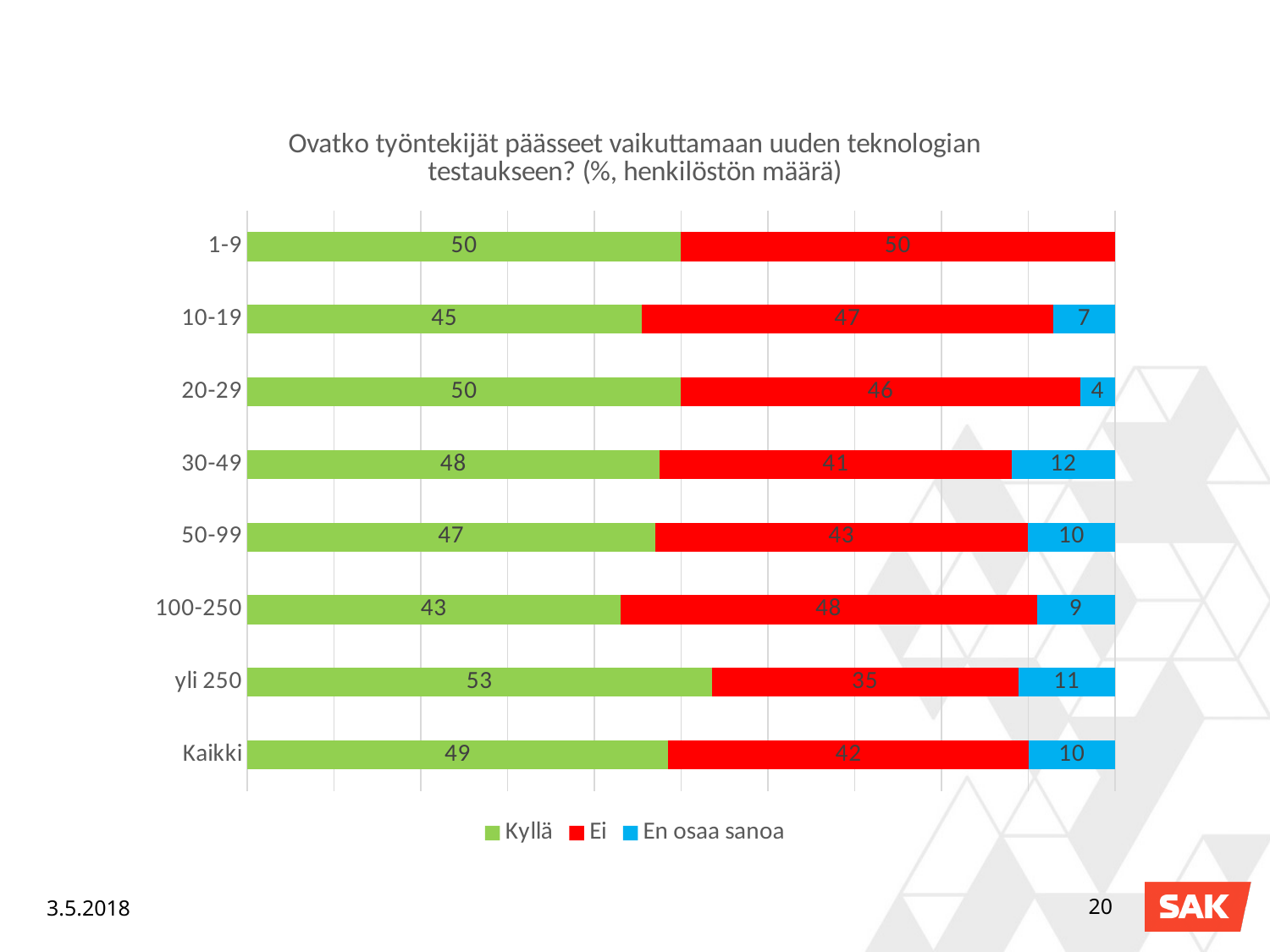
What is the total of the stacked bar for the 30-49 category? 101 Which is larger for the 100-250 category, the Kyllä value or the Ei value? Ei What is the Ei value for the 30-49 category? 41 What is the Kyllä value for the yli 250 category? 53 How many series does the legend list? 3 Which category has the highest Kyllä value? yli 250 What kind of chart is shown on the slide? Stacked bar chart What is the En osaa sanoa value for the 20-29 category? 4 What is the difference between the Kyllä and Ei values for the yli 250 category? 18 How many categories are shown on the y axis? 8 Which category has the lowest Ei value? yli 250 Which colour represents the Ei series in the legend? Red